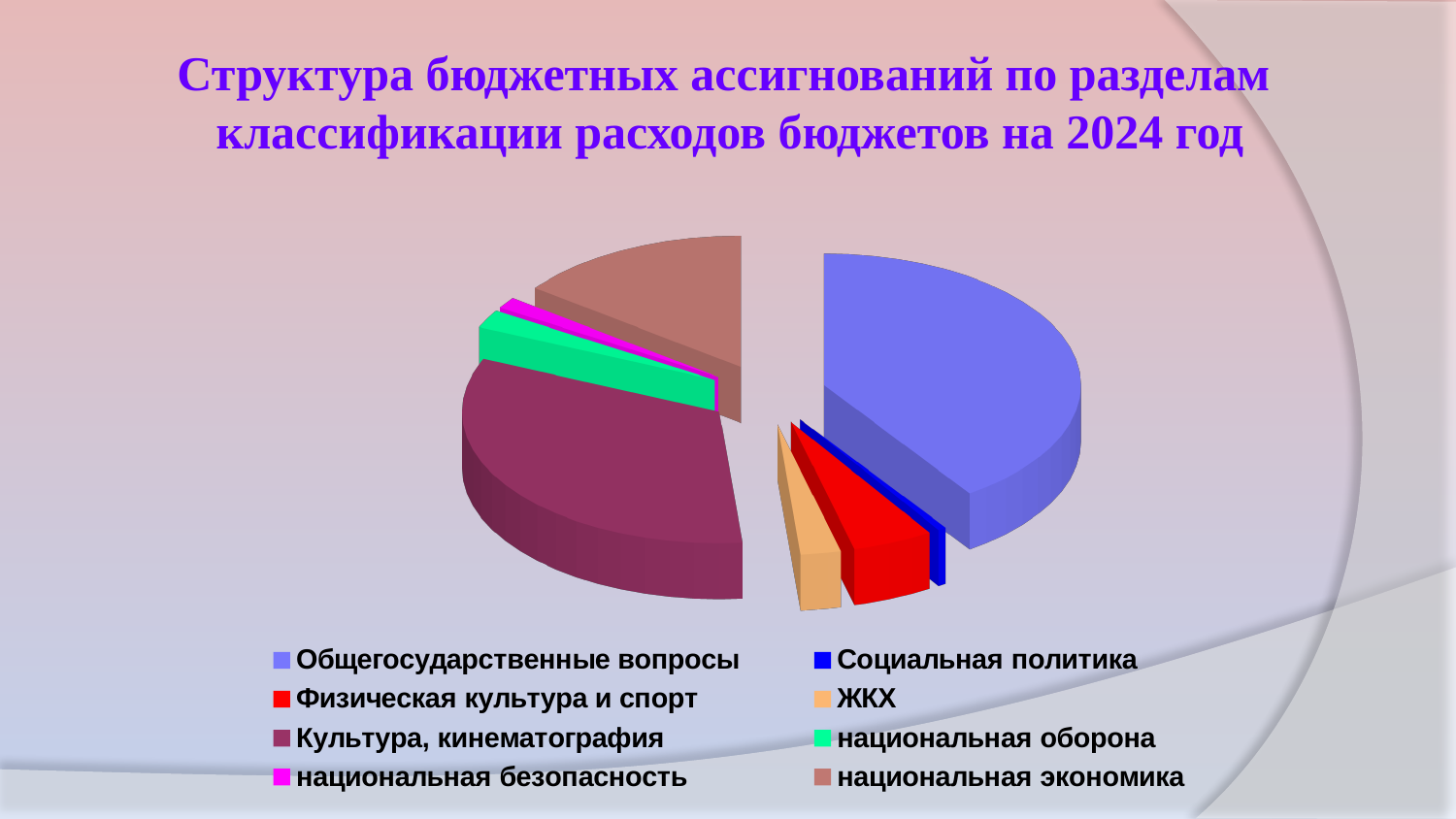
What colour is the slice for Физическая культура и спорт? red How many categories does the pie chart's legend list? 8 Which slice is larger: национальная экономика or национальная оборона? национальная экономика Which slice is larger: Культура, кинематография or Социальная политика? Культура, кинематография Which slice is larger: Культура, кинематография or ЖКХ? Культура, кинематография Which category has the largest slice of the pie? Общегосударственные вопросы What is the title of the chart on the slide? Структура бюджетных ассигнований по разделам классификации расходов бюджетов на 2024 год What kind of chart is shown on the slide? pie chart